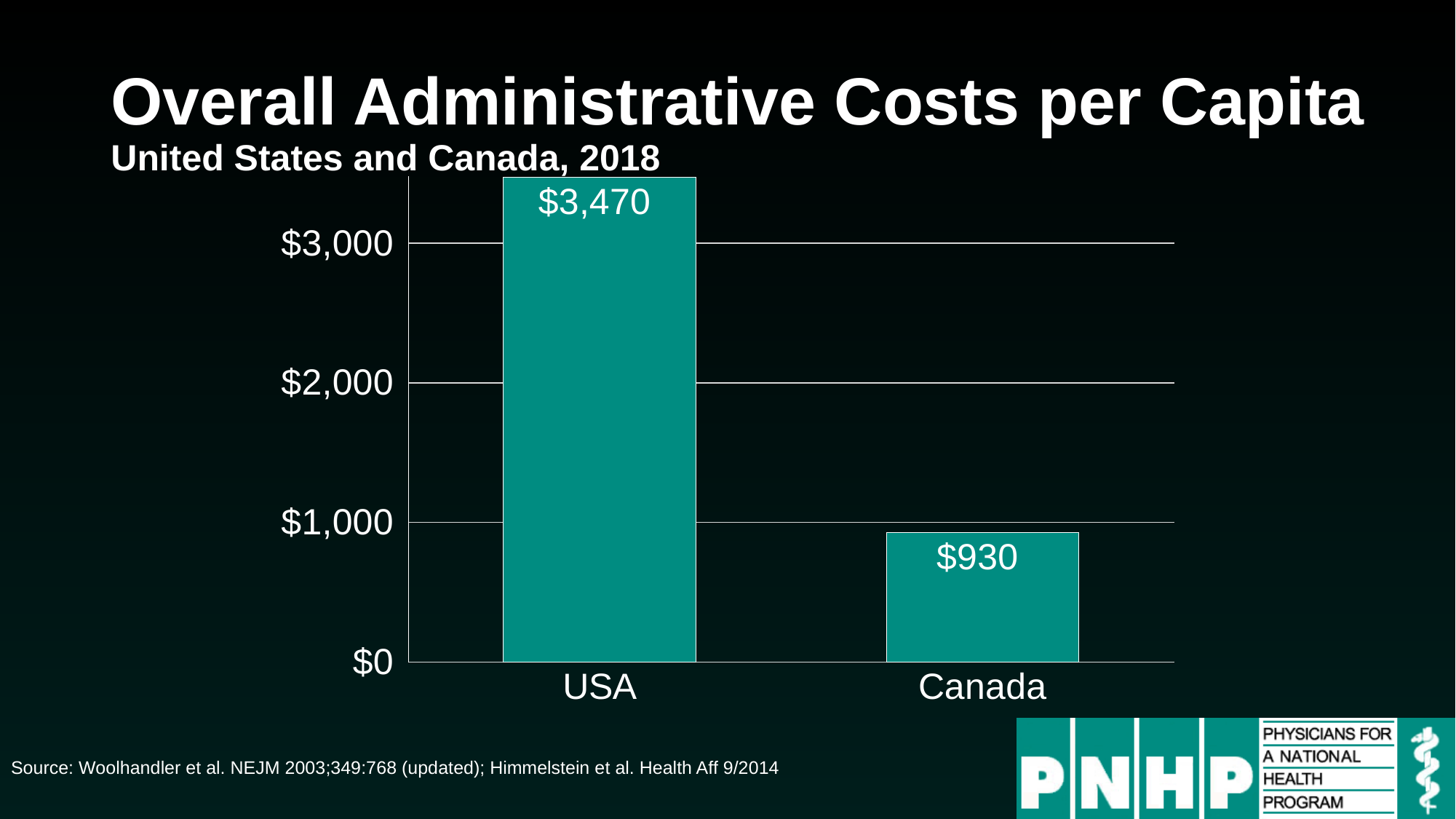
What is the overall administrative cost per capita for Canada? $930 What is the difference between the USA and Canada administrative costs per capita? $2,540 What is the overall administrative cost per capita for the USA? $3,470 What is the title of the chart? Overall Administrative Costs per Capita Which country has the higher administrative cost per capita? USA Is the value for Canada greater or less than $1,000? less How many countries are shown in the chart? 2 Is the value for the USA greater or less than $3,000? greater What type of chart is shown on the slide? bar chart What year does the chart's data refer to? 2018 Is the administrative cost per capita larger for the USA or for Canada? USA Which country has the lower administrative cost per capita? Canada